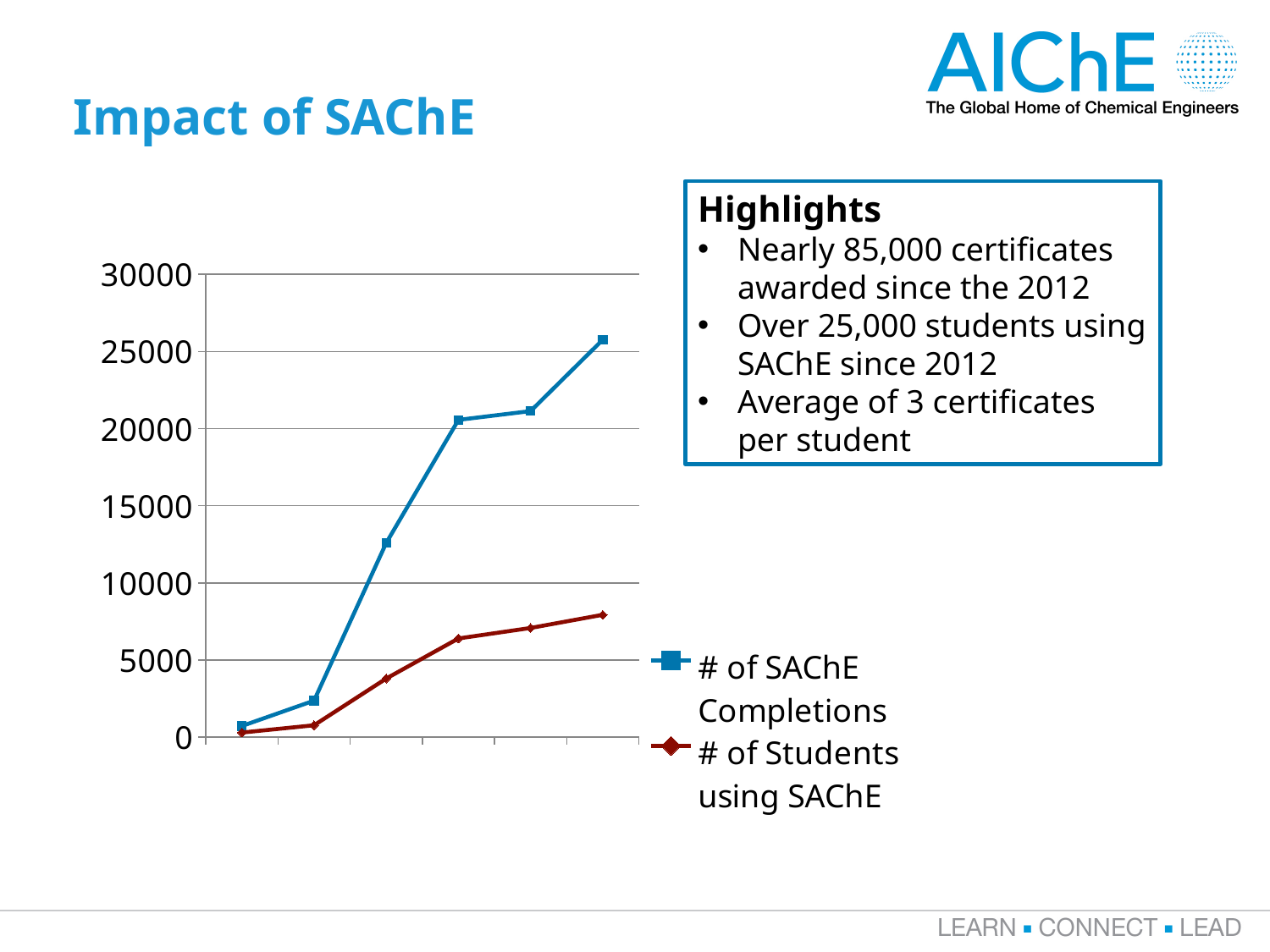
How many data points are plotted for the "# of SAChE Completions" series? 6 Do the values for "# of SAChE Completions" rise or fall from left to right along the x axis? rise Is the rightmost value for "# of SAChE Completions" greater or less than 20000? greater Is the rightmost value for "# of Students using SAChE" greater or less than 5000? greater What kind of chart is shown on the slide? line chart Which series is drawn in blue with square markers? # of SAChE Completions How many series does the chart legend list? 2 At the rightmost point, which series has the larger value: "# of SAChE Completions" or "# of Students using SAChE"? # of SAChE Completions What is the highest value shown on the chart's vertical axis? 30000 Is the rightmost value for "# of Students using SAChE" greater or less than 10000? less Do the values for "# of Students using SAChE" rise or fall from left to right along the x axis? rise